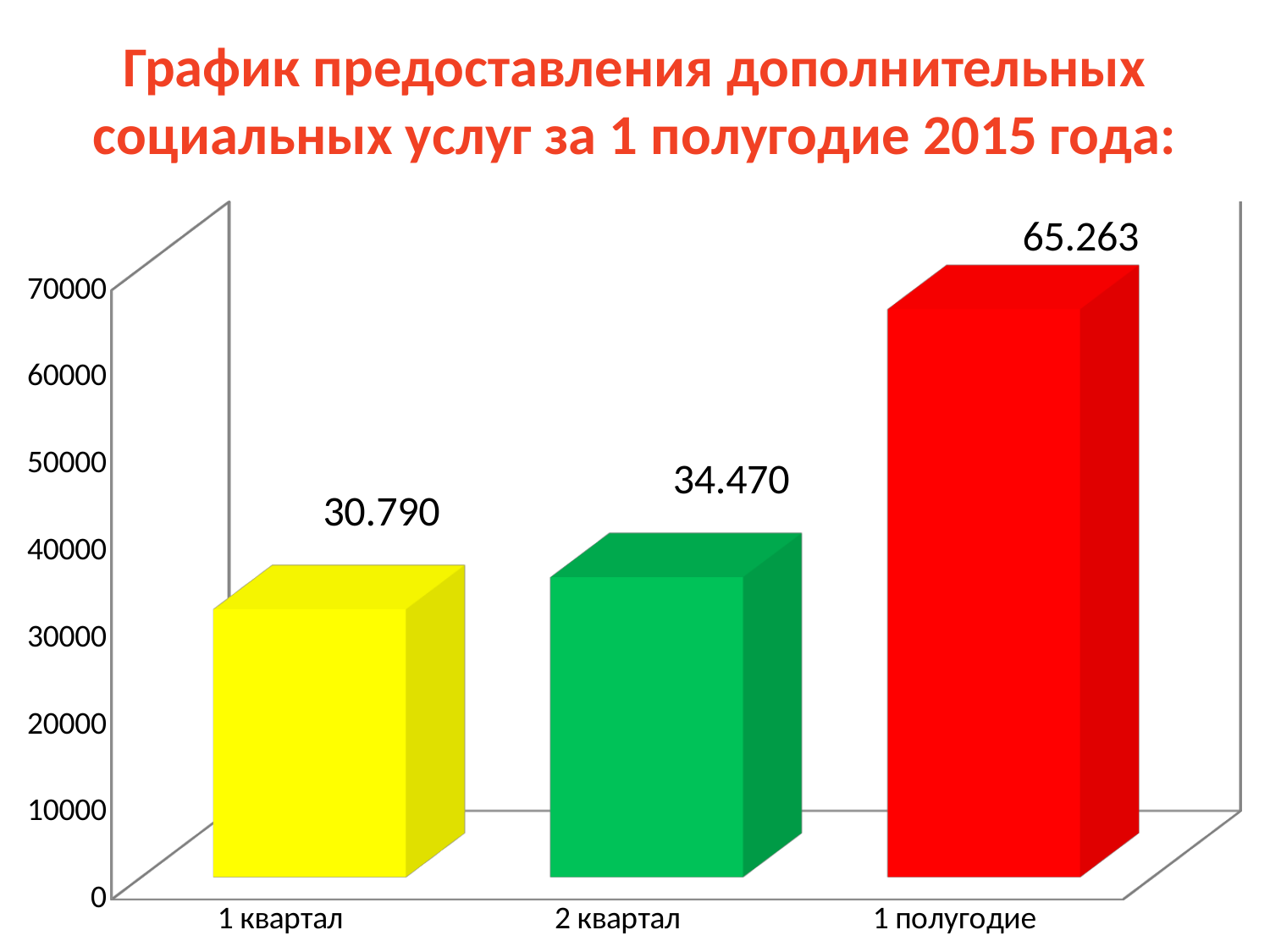
Is the value for 1 полугодие greater or less than 60000? greater What is the value for 1 квартал? 30.790 What is the value for 1 полугодие? 65.263 Which category has the lowest value? 1 квартал Which category has the highest value? 1 полугодие What is the value for 2 квартал? 34.470 What kind of chart is shown on the slide? bar chart What is the difference between the values for 1 полугодие and 2 квартал? 30.793 How many categories are shown on the x axis? 3 Is the value for 1 квартал greater or less than 40000? less Which is larger, the value for 1 квартал or the value for 2 квартал? 2 квартал What is the difference between the values for 2 квартал and 1 квартал? 3.680